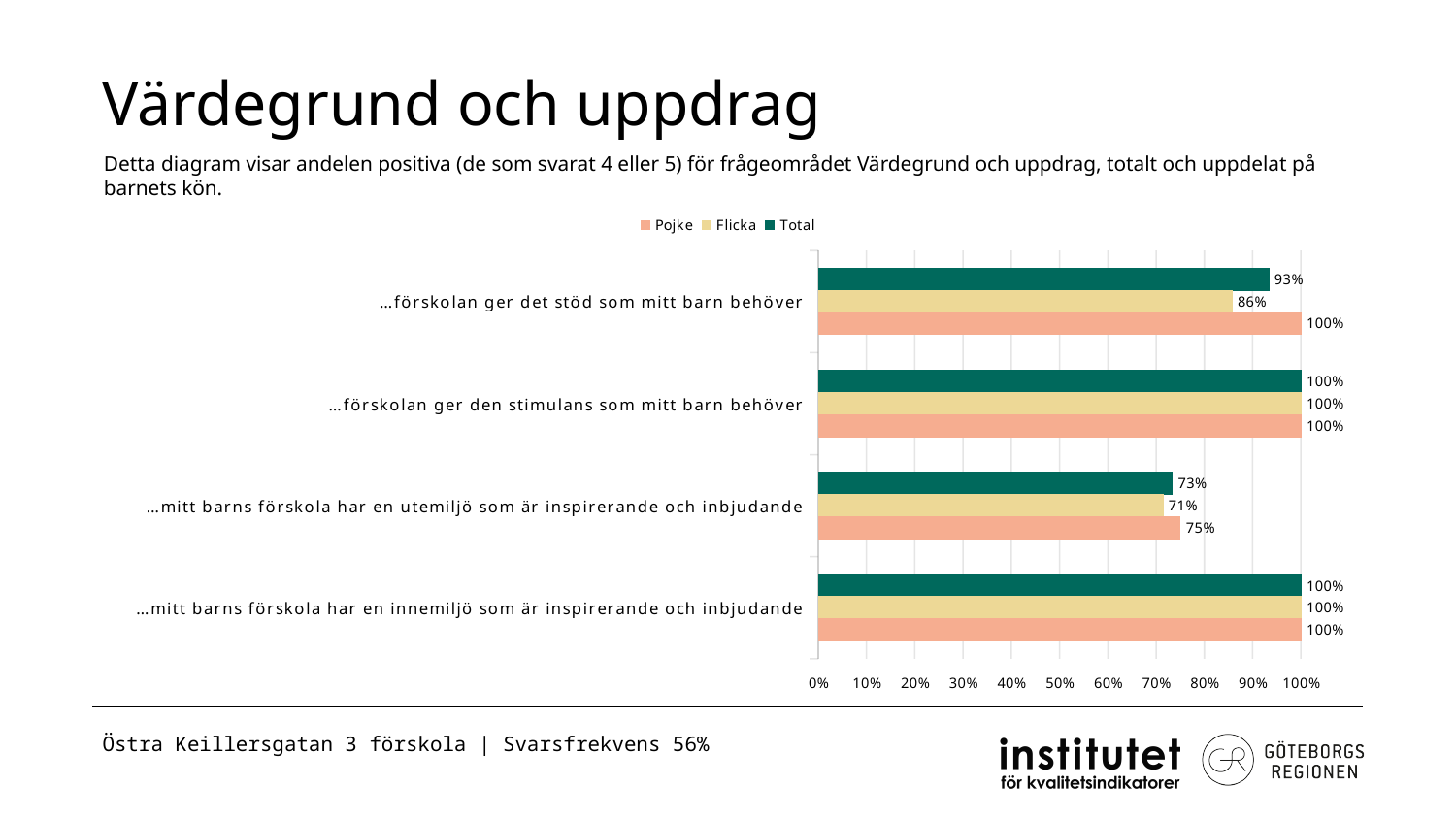
Which category has the lowest Total value? …mitt barns förskola har en utemiljö som är inspirerande och inbjudande Is the Total value for "…mitt barns förskola har en utemiljö som är inspirerande och inbjudande" greater or less than 80%? less What is the Flicka value for "…mitt barns förskola har en utemiljö som är inspirerande och inbjudande"? 71% What is the Total value for "…förskolan ger det stöd som mitt barn behöver"? 93% What kind of chart is shown on the slide? bar chart How many series does the legend list? 3 For "…förskolan ger det stöd som mitt barn behöver", which is larger, the Pojke value or the Flicka value? Pojke How many categories are shown on the chart? 4 What is the difference between the Pojke and Flicka values for "…mitt barns förskola har en utemiljö som är inspirerande och inbjudande"? 4% What is the difference between the Pojke and Flicka values for "…förskolan ger det stöd som mitt barn behöver"? 14% What is the Flicka value for "…förskolan ger det stöd som mitt barn behöver"? 86% What is the Pojke value for "…mitt barns förskola har en utemiljö som är inspirerande och inbjudande"? 75%